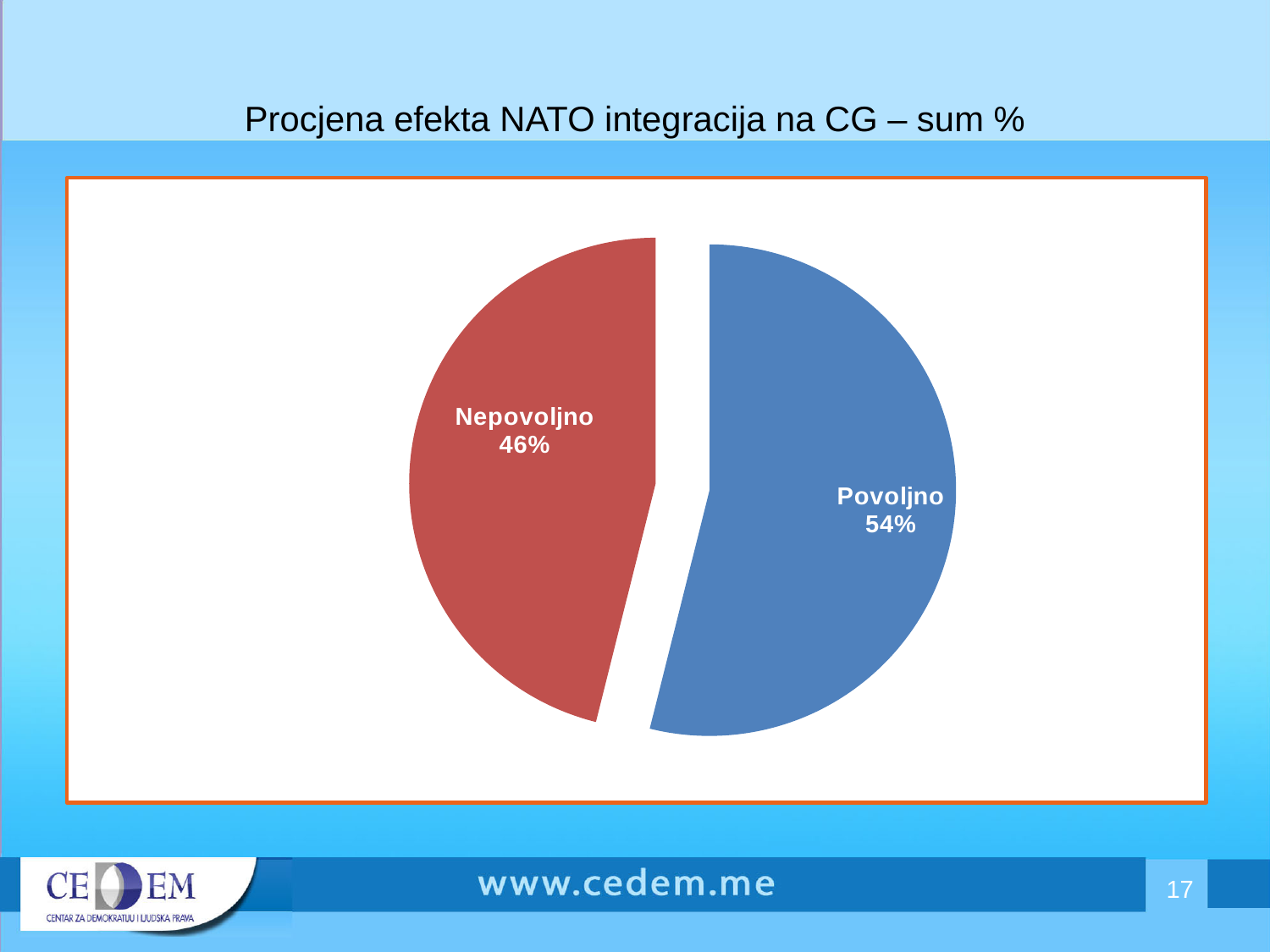
What kind of chart is shown on the slide? pie chart Which is larger, Povoljno or Nepovoljno? Povoljno What is the difference in percentage points between Povoljno and Nepovoljno? 8 Is the value for Nepovoljno greater or less than 50%? less Which slice is the smallest? Nepovoljno What is the title of the slide containing the chart? Procjena efekta NATO integracija na CG – sum % Which slice is the largest? Povoljno What colour is the Povoljno slice? blue What share of the pie does Povoljno have? 54% What share of the pie does Nepovoljno have? 46% How many slices does the pie chart have? 2